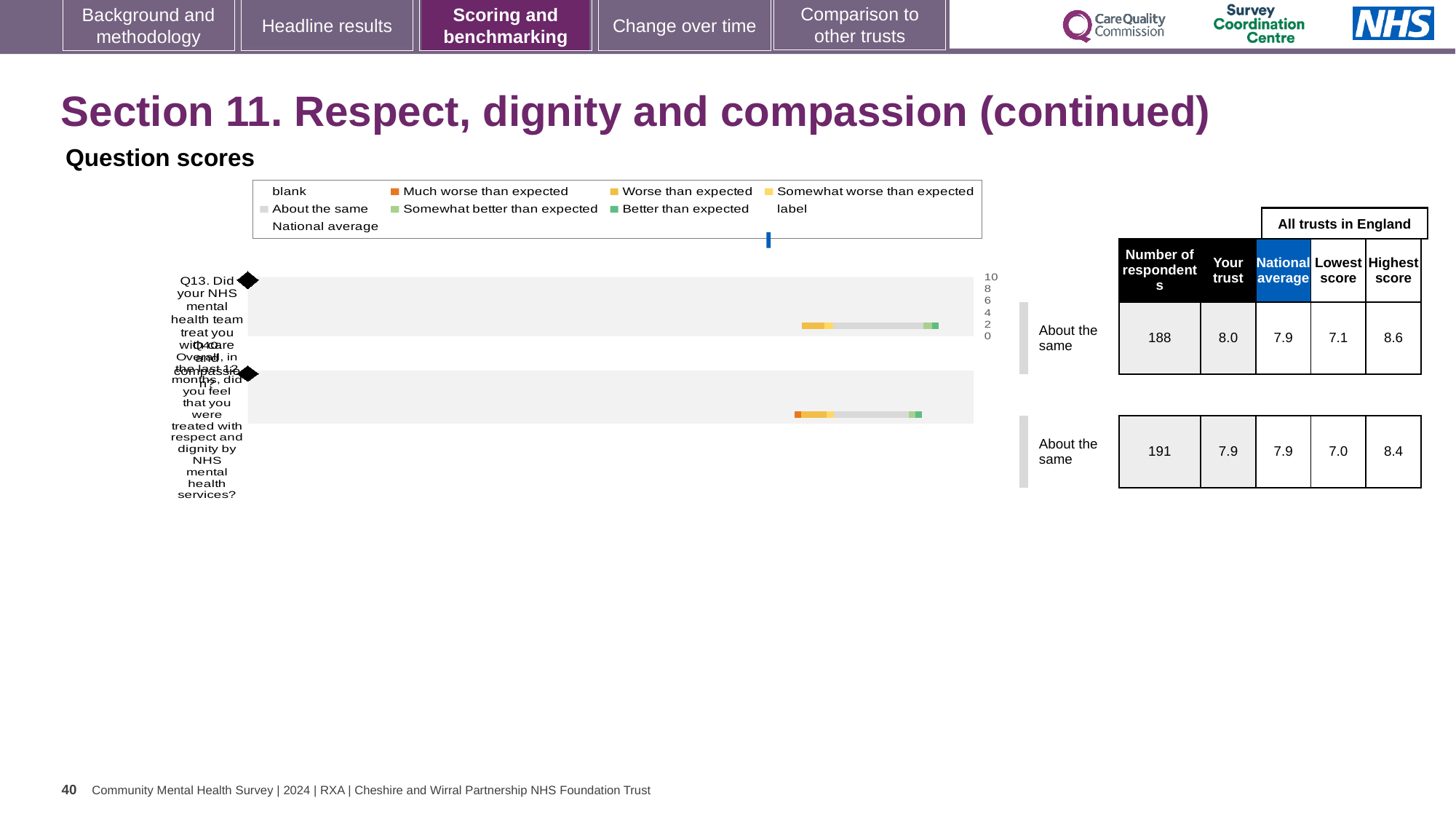
What is the number of respondents for Q13? 188 What is the highest score among all trusts in England for Q13? 8.6 What is the national average score for Q14? 7.9 What is the 'Your trust' score for Q13? 8.0 What kind of chart is shown under 'Question scores'? bar chart What is the difference between the highest score and the lowest score for Q13? 1.5 What benchmark category is shown for Q14? About the same What is the maximum value shown on the chart's score axis? 10 What is the lowest score among all trusts in England for Q14? 7.0 Which question has the higher 'Your trust' score, Q13 or Q14? Q13 How many survey questions are plotted in the chart? 2 What is the number of respondents for Q14? 191